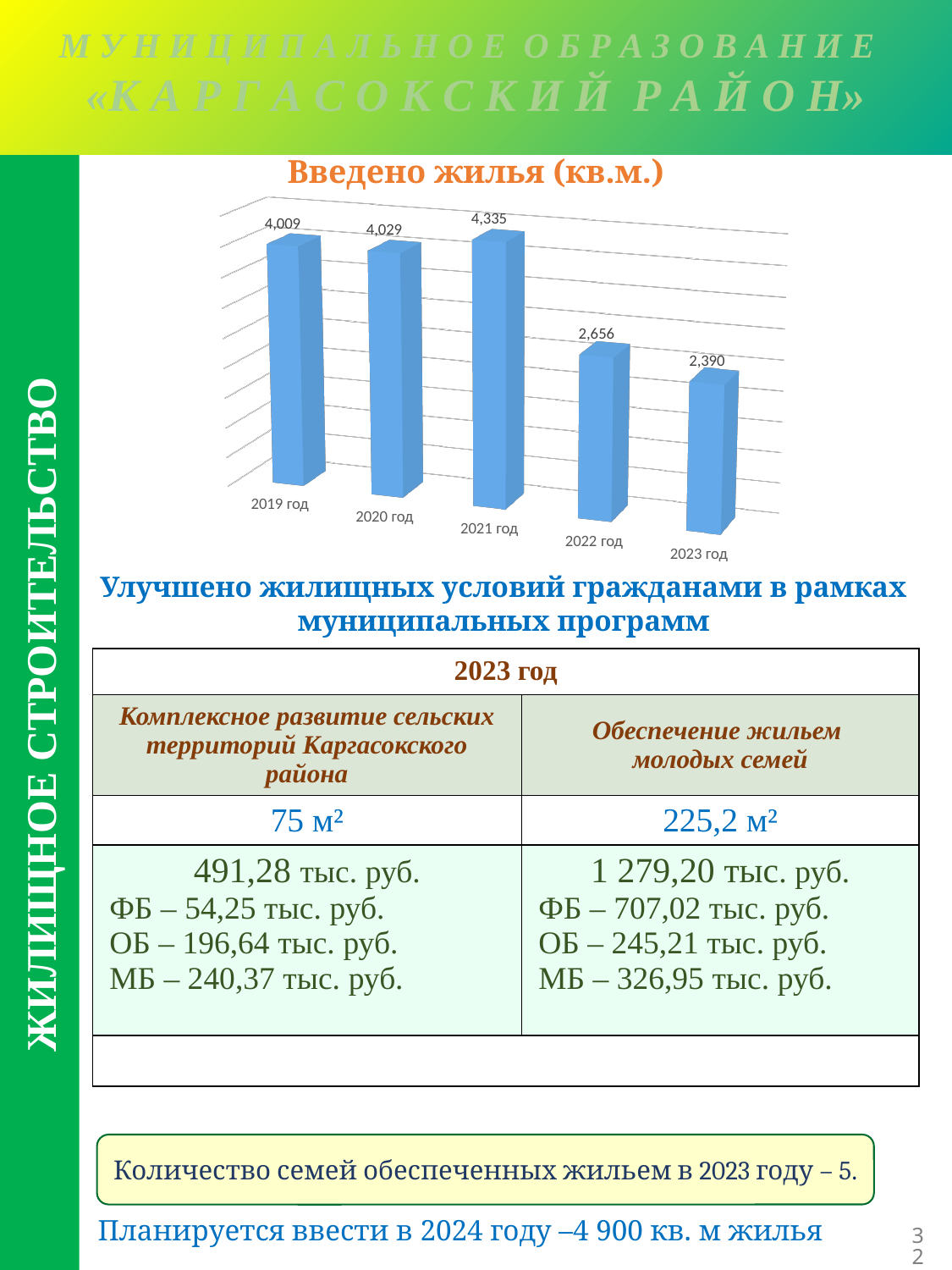
What is the difference between the values for 2022 год and 2023 год in the chart 'Введено жилья (кв.м.)'? 266 What value is shown for 2019 год in the chart 'Введено жилья (кв.м.)'? 4,009 In the chart 'Введено жилья (кв.м.)', which is larger: the value for 2021 год or the value for 2022 год? 2021 год What is the title of the chart on the slide? Введено жилья (кв.м.) Which year has the highest value in the chart 'Введено жилья (кв.м.)'? 2021 год Which year has the lowest value in the chart 'Введено жилья (кв.м.)'? 2023 год What value is shown for 2021 год in the chart 'Введено жилья (кв.м.)'? 4,335 What is the difference between the values for 2021 год and 2023 год in the chart 'Введено жилья (кв.м.)'? 1,945 How many years are shown in the chart 'Введено жилья (кв.м.)'? 5 What kind of chart is 'Введено жилья (кв.м.)'? Bar chart What value is shown for 2023 год in the chart 'Введено жилья (кв.м.)'? 2,390 In the chart 'Введено жилья (кв.м.)', do the values rise or fall from 2021 год to 2023 год? Fall